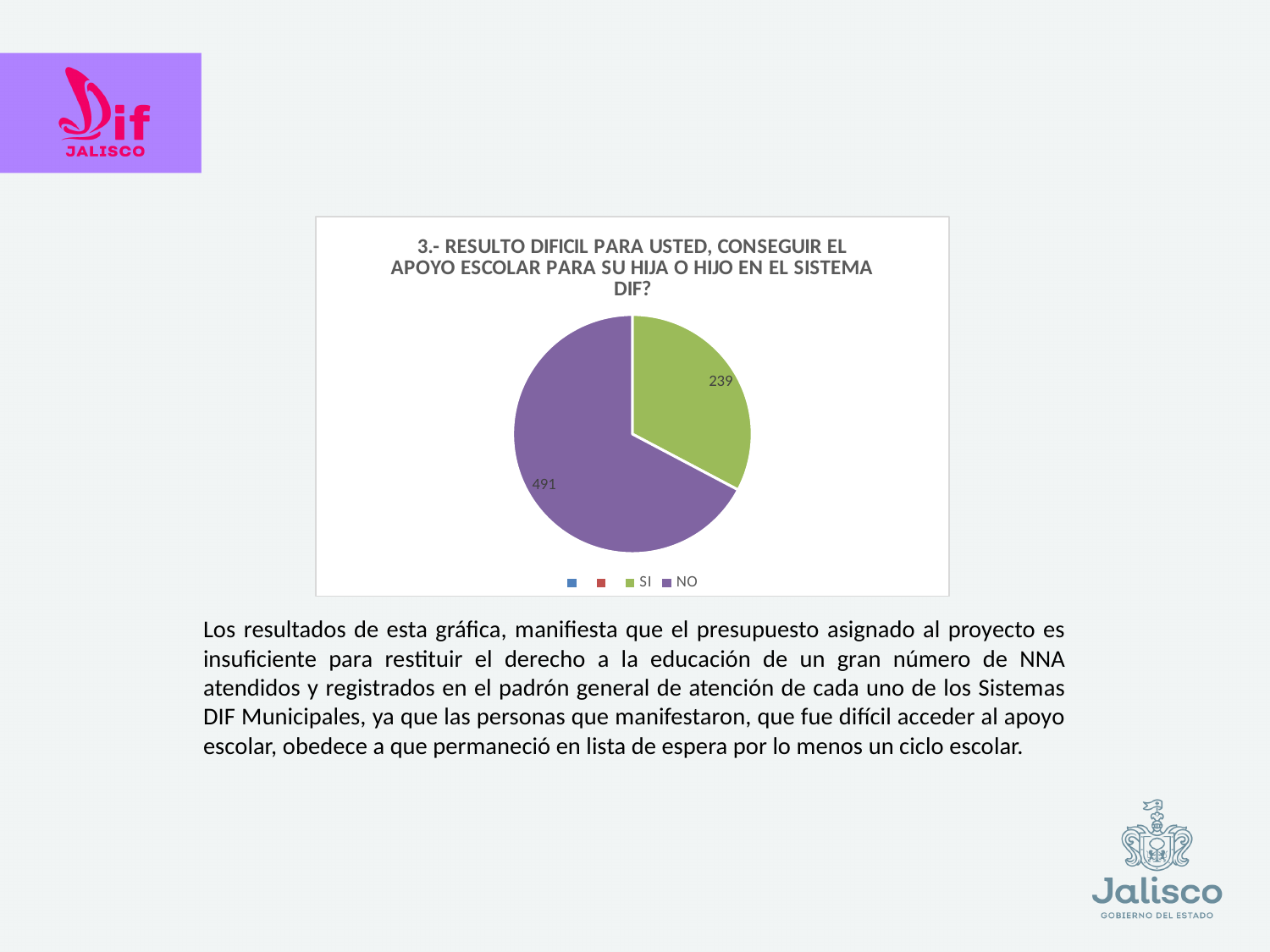
What colour is the NO slice in the pie chart? purple What share of the pie does the NO slice represent? 67.3% What is the difference between the NO value and the SI value? 252 What kind of chart is shown on the slide? pie chart Which category has the largest slice in the pie chart? NO Which is larger, the value for SI or the value for NO? NO What is the total of the two values shown in the pie chart? 730 What is the value for NO in the pie chart? 491 What is the value for SI in the pie chart? 239 Which category has the smallest slice in the pie chart? SI What share of the pie does the SI slice represent? 32.7% How many slices are shown in the pie chart? 2